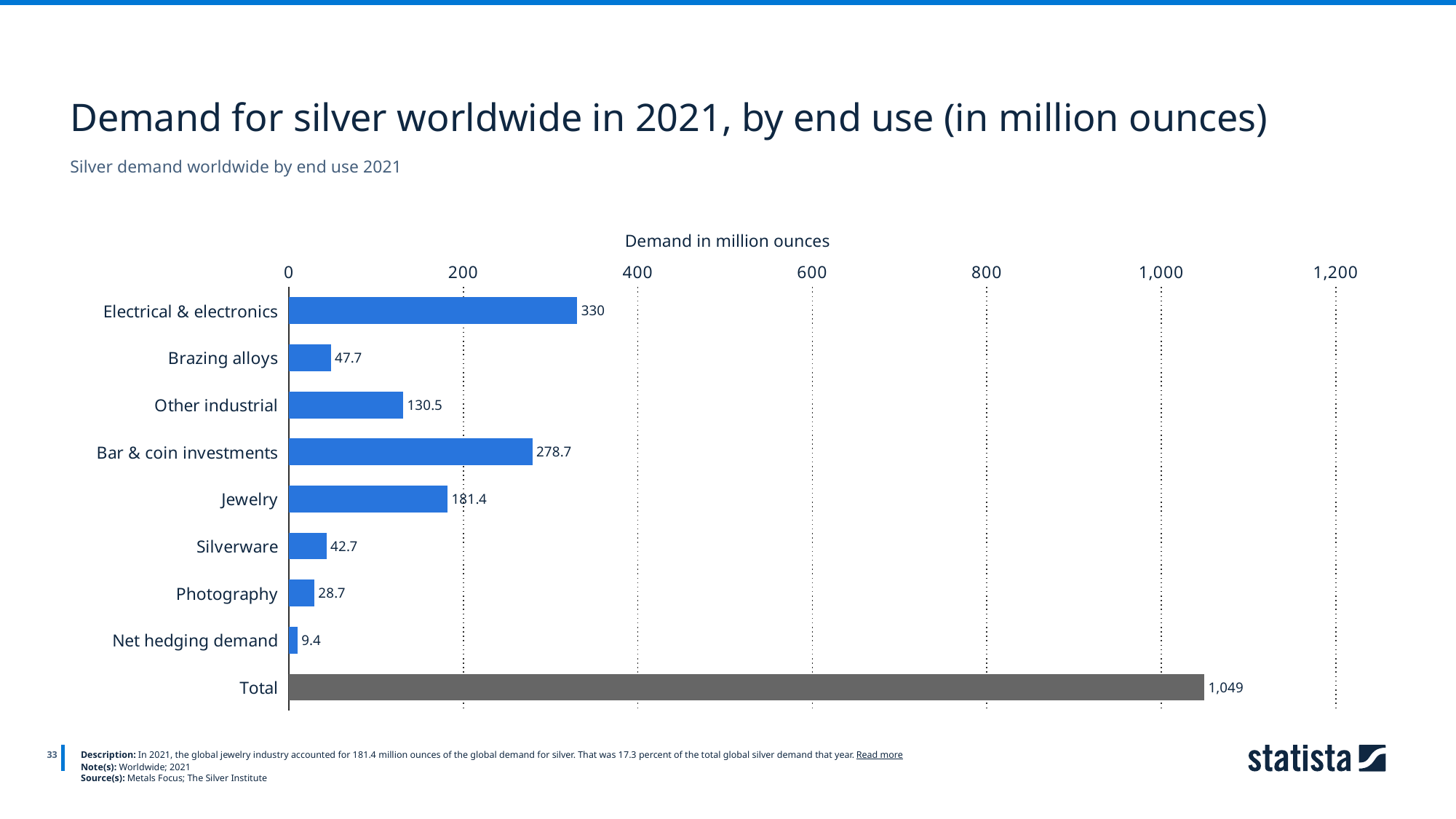
What is the demand for silver in electrical & electronics? 330 What is the demand for silver in jewelry? 181.4 How many bars are shown in the chart, including the Total bar? 9 Is the value for other industrial greater or less than 200? less Which end use has the lowest silver demand? Net hedging demand What type of chart is shown on the slide? Bar chart Excluding the Total bar, which end use has the highest silver demand? Electrical & electronics What is the difference between the demand for bar & coin investments and the demand for jewelry? 97.3 What is the value of the Total bar? 1,049 What is the value shown for net hedging demand? 9.4 Which is larger, the demand for brazing alloys or the demand for silverware? Brazing alloys What is the label of the horizontal axis? Demand in million ounces